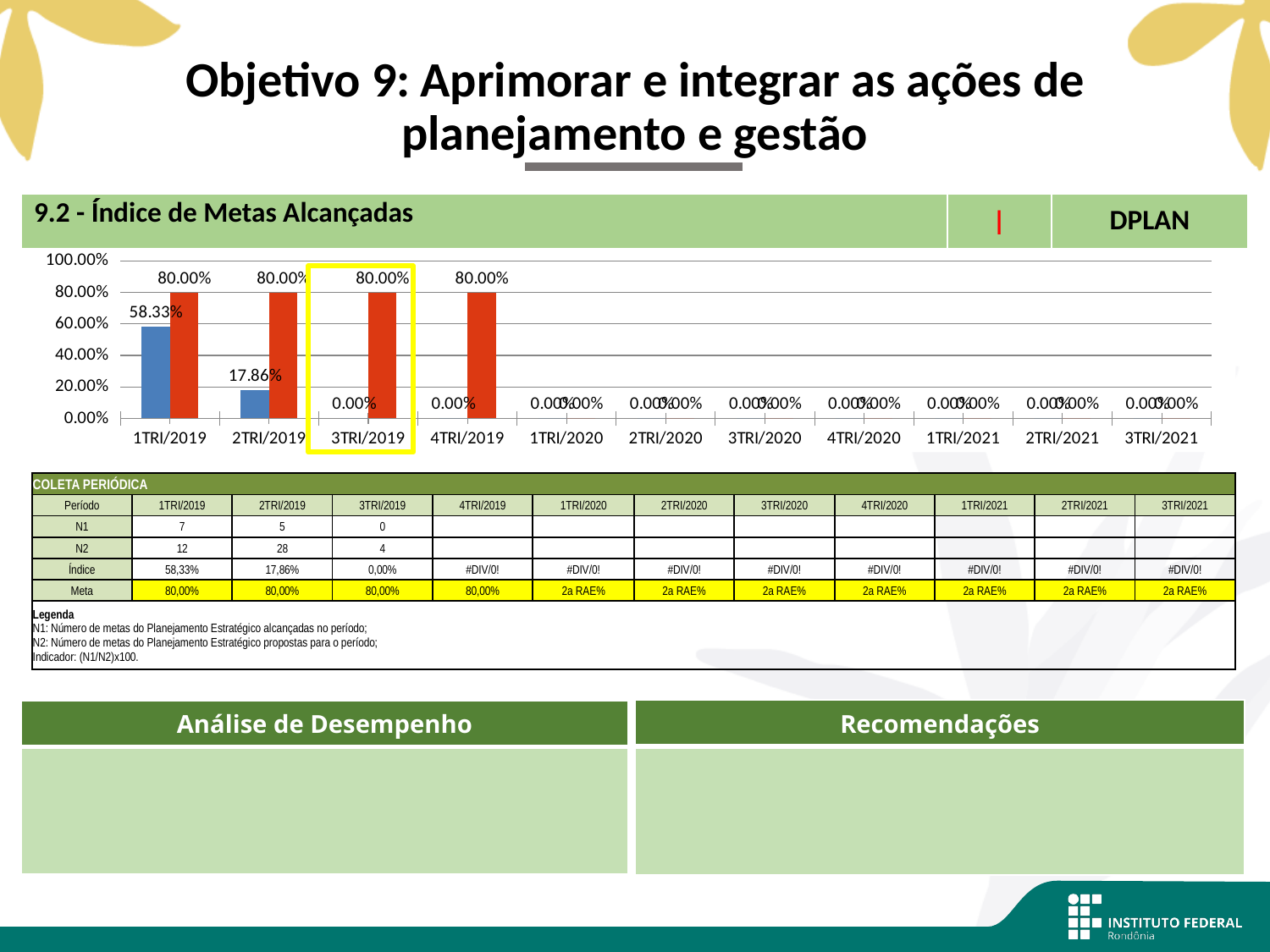
What is the difference between the red bar (Meta) and the blue bar (Índice) for 1TRI/2019? 21.67% What is the difference between the blue bar (Índice) values for 1TRI/2019 and 2TRI/2019? 40.47% Which period has the highest blue bar (Índice) value? 1TRI/2019 Which period on the chart is highlighted with a yellow box? 3TRI/2019 How many periods (categories) are shown on the x axis of the chart? 11 What is the value of the blue bar (Índice) for 3TRI/2019? 0.00% What type of chart is shown on the slide? bar chart Does the blue bar (Índice) value fall or rise from 1TRI/2019 to 3TRI/2019? fall What is the value of the blue bar (Índice) for 2TRI/2019? 17.86% Which is larger for 2TRI/2019, the blue bar (Índice) or the red bar (Meta)? the red bar (Meta) What is the value of the red bar (Meta) for 3TRI/2019? 80.00% What is the value of the blue bar (Índice) for 1TRI/2019? 58.33%